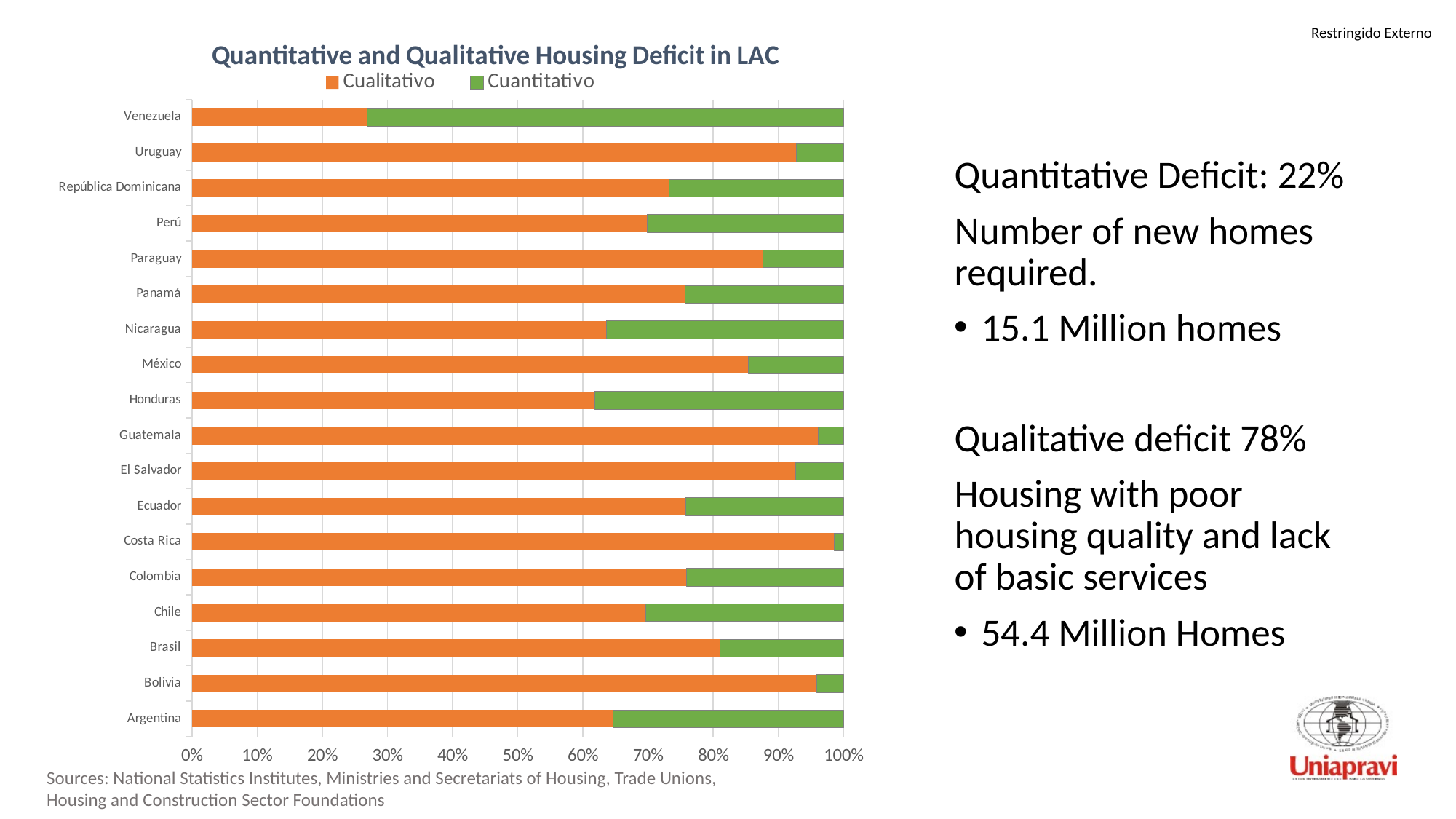
What is the total of the stacked bar for Argentina? 100% Which series is shown in green in the chart? Cuantitativo Which country has the smallest Cuantitativo share? Costa Rica Is the Cualitativo value for Guatemala greater or less than 90%? greater Is the Cualitativo value for Venezuela greater or less than 30%? less Which country has the largest Cuantitativo share? Venezuela How many series does the chart legend list? 2 How many countries are listed on the chart? 18 Is the Cualitativo value for Honduras greater or less than 60%? greater What kind of chart is shown on the slide? Stacked bar chart Which has the larger Cualitativo share, Honduras or México? México What is the title of the chart? Quantitative and Qualitative Housing Deficit in LAC